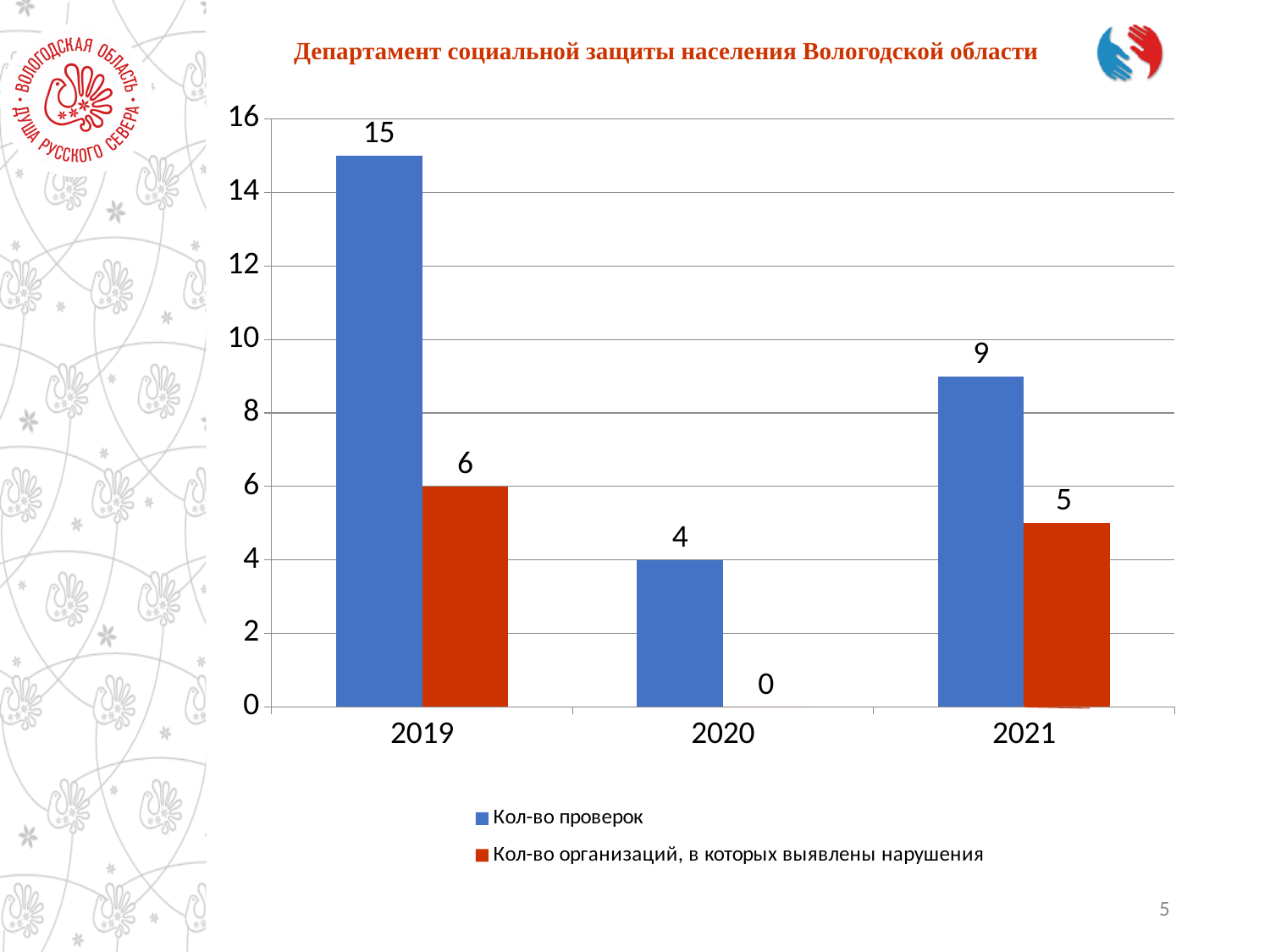
Which colour represents "Кол-во проверок" in the chart? Blue Which year has the highest value for "Кол-во проверок"? 2019 What is the value of "Кол-во организаций, в которых выявлены нарушения" for 2021? 5 How many years are shown on the x axis? 3 How many series does the legend list? 2 What is the value of "Кол-во организаций, в которых выявлены нарушения" for 2020? 0 Which is larger: "Кол-во проверок" in 2020 or "Кол-во организаций, в которых выявлены нарушения" in 2021? Кол-во организаций, в которых выявлены нарушения in 2021 What kind of chart is shown on the slide? Bar chart What is the difference between "Кол-во проверок" in 2019 and 2021? 6 What is the value of "Кол-во проверок" for 2019? 15 Which year has the lowest value for "Кол-во проверок"? 2020 What is the difference between "Кол-во проверок" and "Кол-во организаций, в которых выявлены нарушения" in 2019? 9